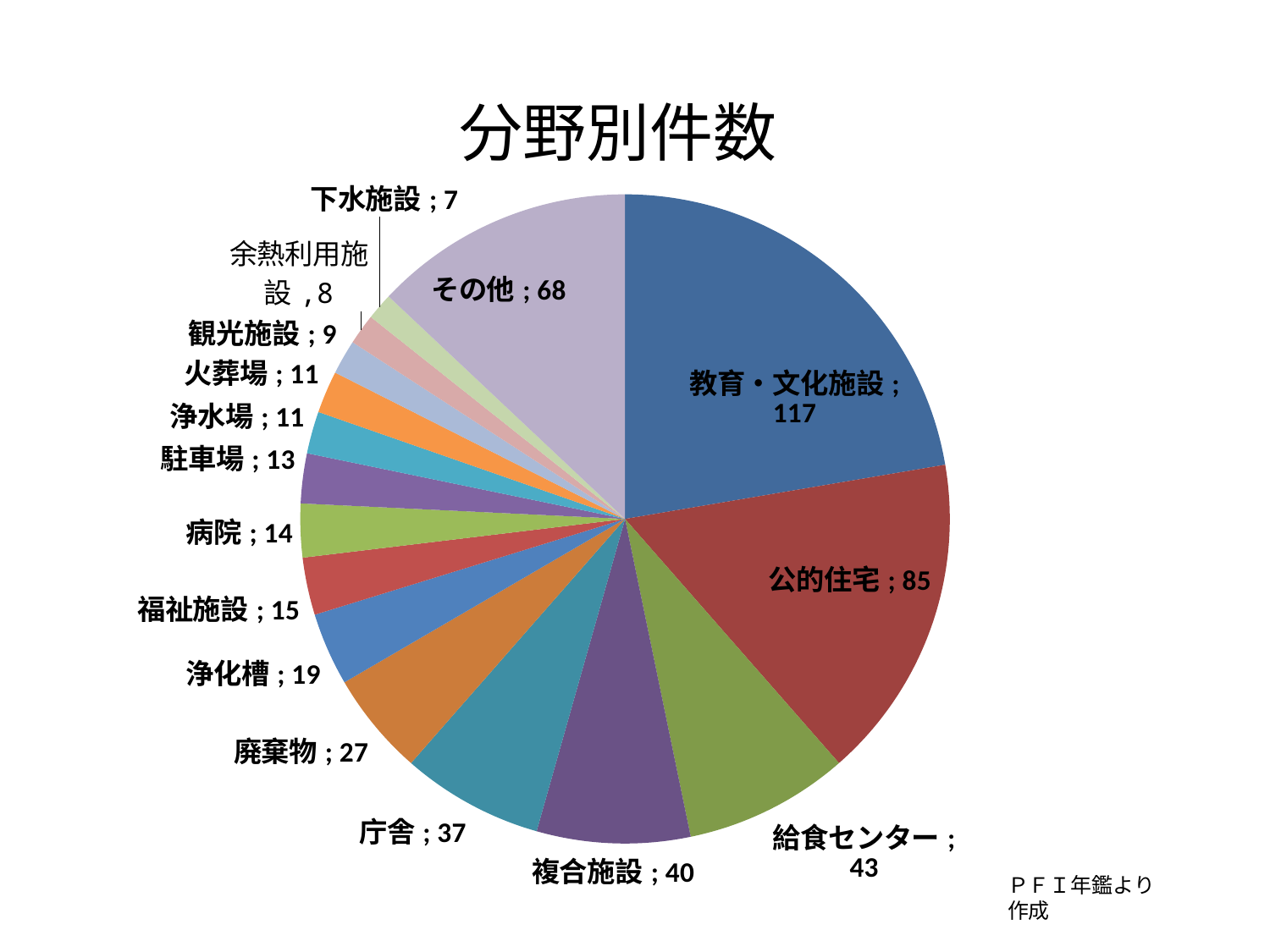
Which category has the largest slice? 教育・文化施設 What is the title of the chart? 分野別件数 What kind of chart is shown on the slide? pie chart What is the value for 下水施設? 7 Which is larger, 給食センター or 複合施設? 給食センター How many categories are shown in the pie chart? 16 What is the difference between the values for 教育・文化施設 and 公的住宅? 32 What is the difference between the values for その他 and 廃棄物? 41 What is the value for 教育・文化施設? 117 Which category has the smallest slice? 下水施設 What is the value for 公的住宅? 85 What is the value for 庁舎? 37